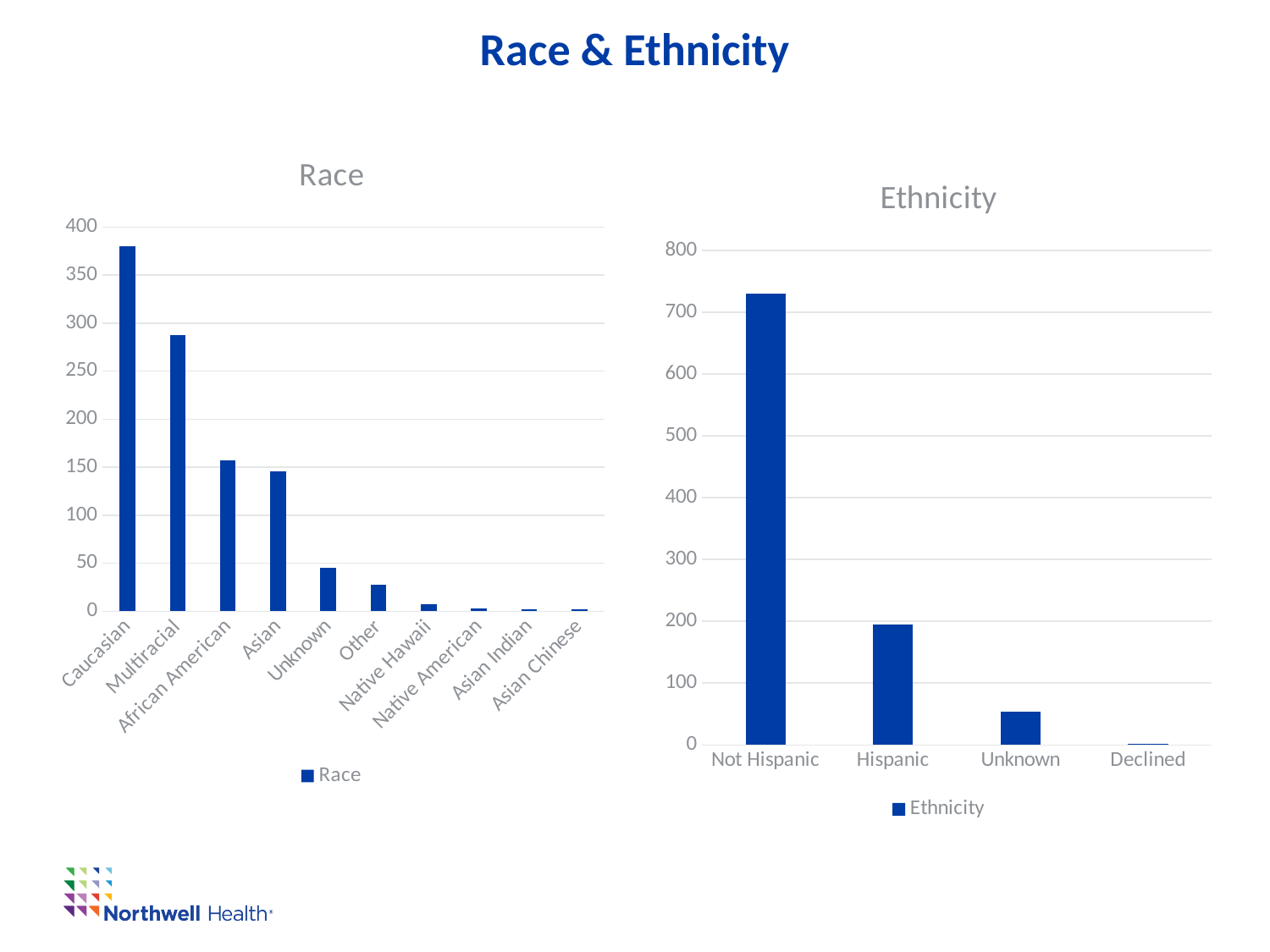
On the Race chart, is the value for Other greater or less than 50? less On the Race chart, is the value for Caucasian greater or less than 350? greater On the Ethnicity chart, which category has the lowest value? Declined What kind of chart is the Ethnicity chart? bar chart On the Race chart, which category has the highest value? Caucasian On the Ethnicity chart, which category has the highest value? Not Hispanic On the Ethnicity chart, is the value for Not Hispanic greater or less than 700? greater On the Ethnicity chart, which is larger, Hispanic or Unknown? Hispanic On the Race chart, which is larger, Caucasian or Multiracial? Caucasian How many categories are shown on the Race chart? 10